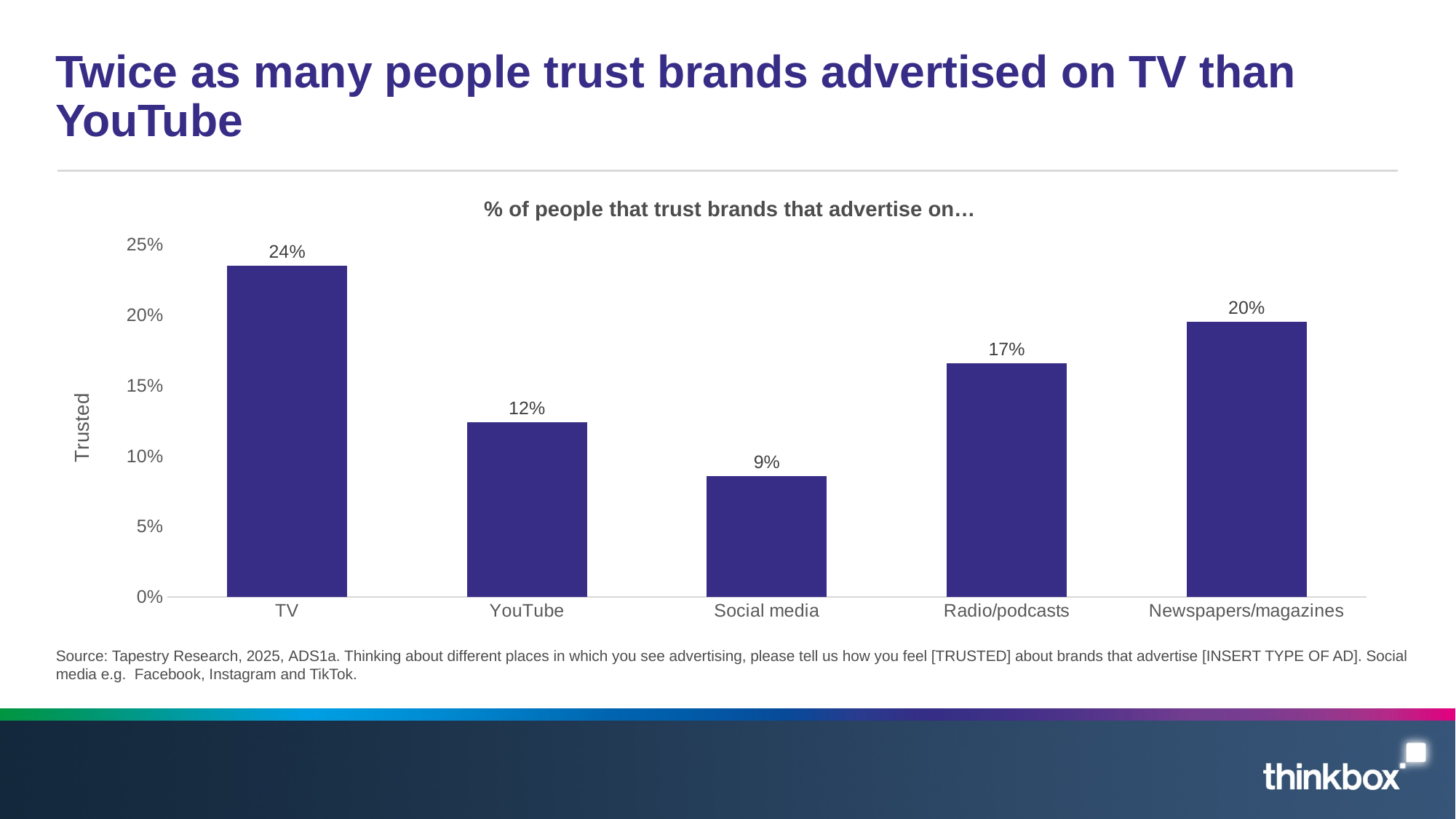
What percentage of people trust brands that advertise on Radio/podcasts? 17% What kind of chart is shown on the slide? Bar chart Which is larger, the value for Newspapers/magazines or the value for Radio/podcasts? Newspapers/magazines What is the label on the vertical axis of the chart? Trusted What is the title of the chart? % of people that trust brands that advertise on… Which category has the highest percentage of people trusting brands advertised on it? TV How many categories are shown on the x axis of the chart? 5 Which category has the lowest percentage of people trusting brands advertised on it? Social media What percentage of people trust brands that advertise on TV? 24% What is the difference in percentage points between TV and YouTube? 12 Is the value for YouTube greater or less than 15%? less What percentage of people trust brands that advertise on Social media? 9%